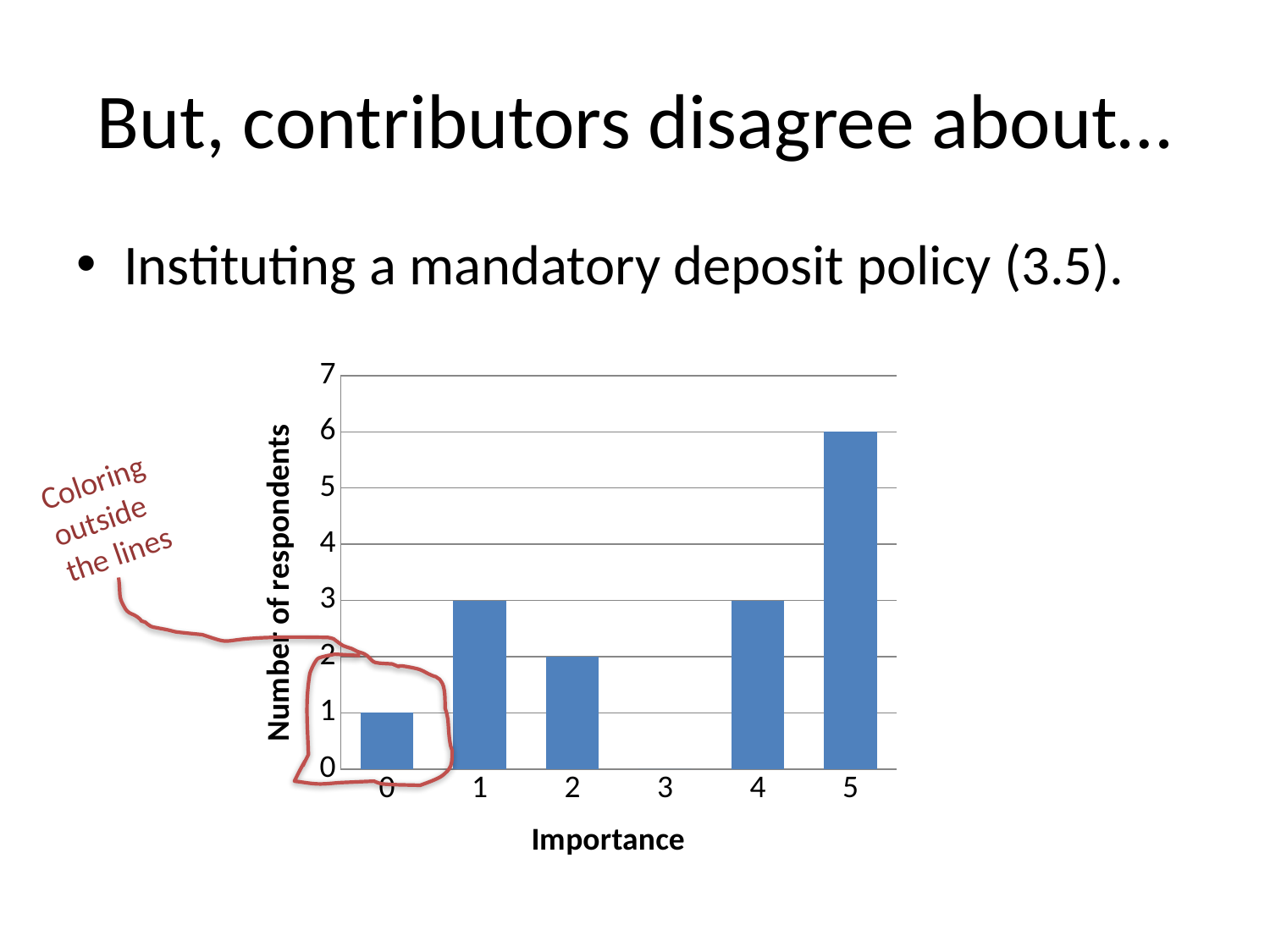
How many respondents gave an importance rating of 2? 2 Which importance rating has the highest number of respondents? 5 How many importance categories are shown on the x axis? 6 What is the label of the x axis? Importance Which has more respondents: importance rating 1 or importance rating 2? importance rating 1 What is the label of the y axis? Number of respondents How many respondents gave an importance rating of 5? 6 What kind of chart is shown on the slide? bar chart How many respondents gave an importance rating of 0? 1 Which importance rating has no respondents at all? 3 Is the number of respondents for importance rating 5 greater or less than 4? greater What is the difference in number of respondents between importance rating 5 and importance rating 1? 3